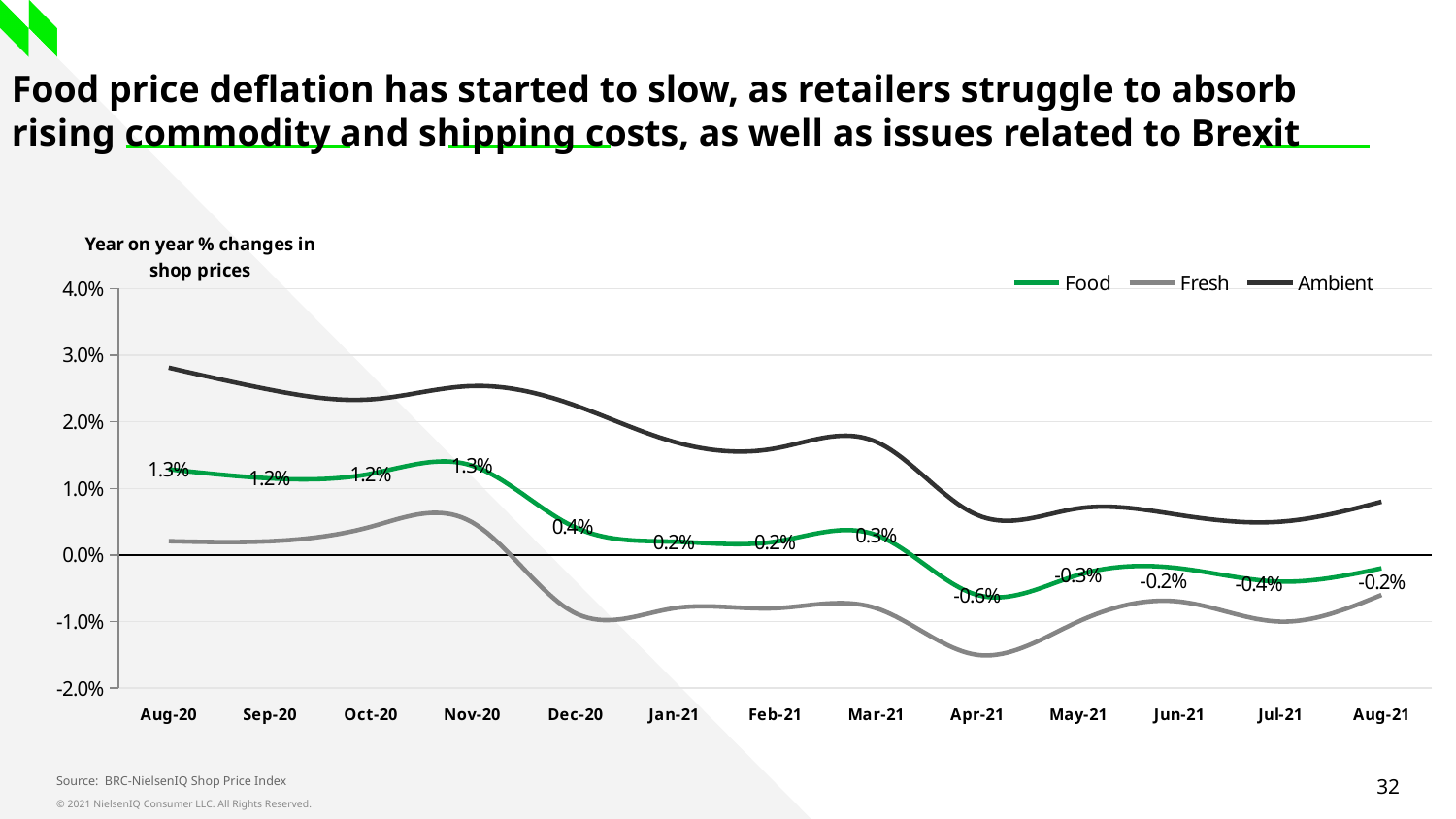
What is the Food value for Apr-21? -0.6% How many months are shown on the x axis? 13 What is the Food value for Aug-21? -0.2% In which month is the Food series at its lowest value? Apr-21 Which is larger, the Food value for Dec-20 or the Food value for Mar-21? Dec-20 Does the Food series rise or fall from Aug-20 to Aug-21? Fall Is the Fresh value for Apr-21 greater or less than -1.0%? less What is the difference between the Food value in Aug-20 and the Food value in Aug-21? 1.5 percentage points What is the Food value for Dec-20? 0.4% Is the Ambient value for Aug-20 greater or less than 2.0%? greater How many series does the legend list? 3 What kind of chart is shown on the slide? Line chart